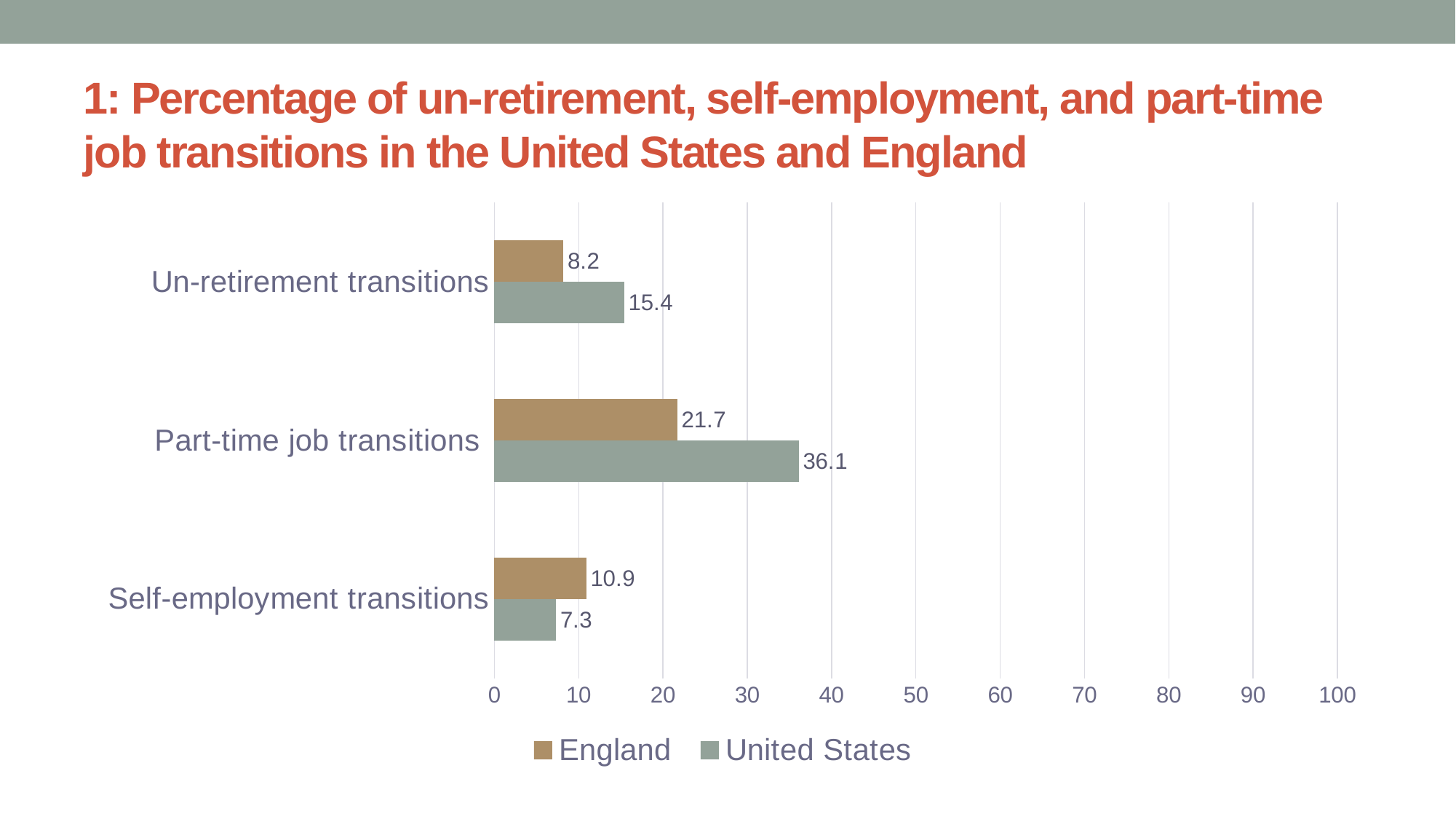
How many series does the legend list? 2 What is the value for United States for Part-time job transitions? 36.1 Which category has the lowest value for England? Un-retirement transitions What is the value for United States for Self-employment transitions? 7.3 Is the United States value for Un-retirement transitions greater or less than 10? greater What is the difference between the United States and England values for Part-time job transitions? 14.4 What is the maximum value shown on the horizontal axis? 100 Which category has the highest value for United States? Part-time job transitions For Self-employment transitions, which is larger: England or United States? England How many categories are shown on the chart? 3 What is the value for England for Un-retirement transitions? 8.2 What kind of chart is shown on the slide? Bar chart